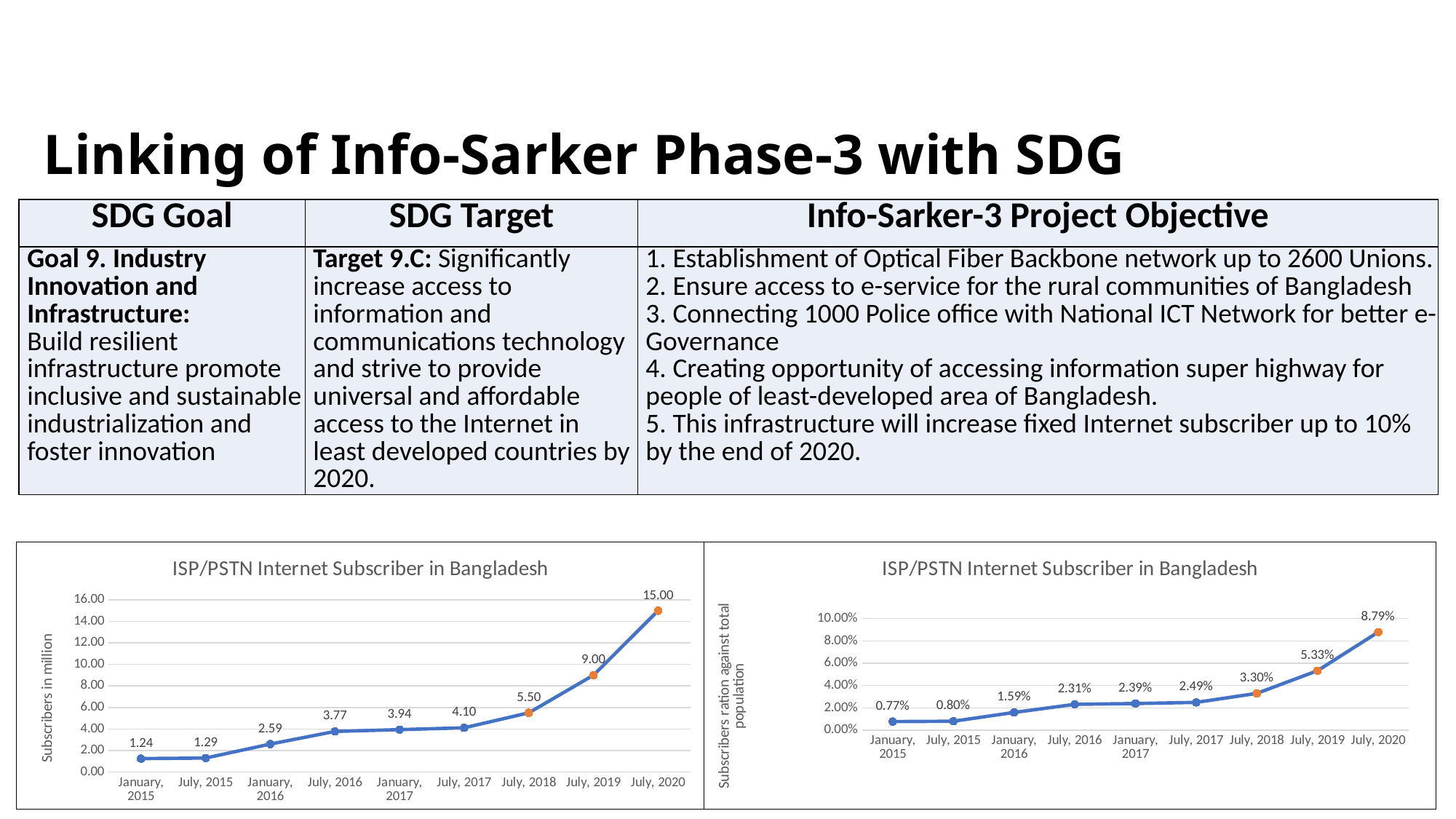
In the left chart, what is the difference between the values for July, 2020 and July, 2019? 6.00 In the right chart, which point has the highest value? July, 2020 In the right chart, what is the value for July, 2016? 2.31% In the right chart, what is the difference between the values for July, 2018 and July, 2017? 0.81% In the right chart, what is the value for July, 2019? 5.33% In the left chart, which point has the lowest value? January, 2015 In the left chart, which is larger, the value for July, 2018 or the value for July, 2017? July, 2018 In the right chart, do the values rise or fall from January, 2015 to July, 2020? Rise How many data points are plotted in the right chart? 9 What kind of chart is the left chart? Line chart In the left chart, what is the value for January, 2016? 2.59 In the left chart, what is the value for July, 2020? 15.00